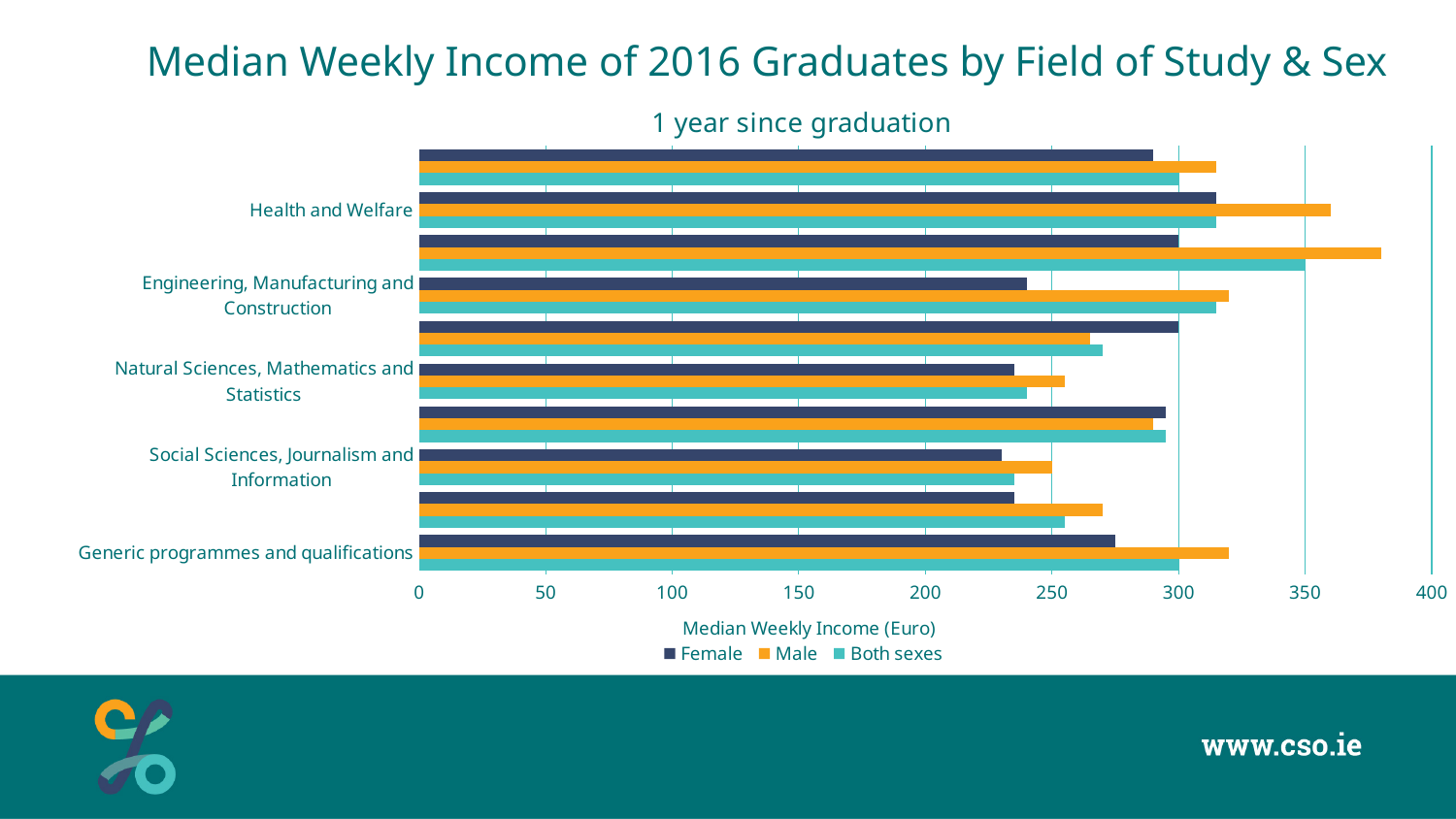
Is the Male value for Engineering, Manufacturing and Construction greater or less than 300? greater What is the x-axis title of the chart? Median Weekly Income (Euro) Is the Female value for Engineering, Manufacturing and Construction greater or less than 250? less Is the Male value for Generic programmes and qualifications greater or less than 300? greater What kind of chart is shown on the slide? Bar chart Which series has the highest value for Health and Welfare? Male For Health and Welfare, which is larger, the Male value or the Female value? Male What is the subtitle shown above the chart? 1 year since graduation How many series does the legend list? 3 For Engineering, Manufacturing and Construction, which is larger, the Male value or the Female value? Male